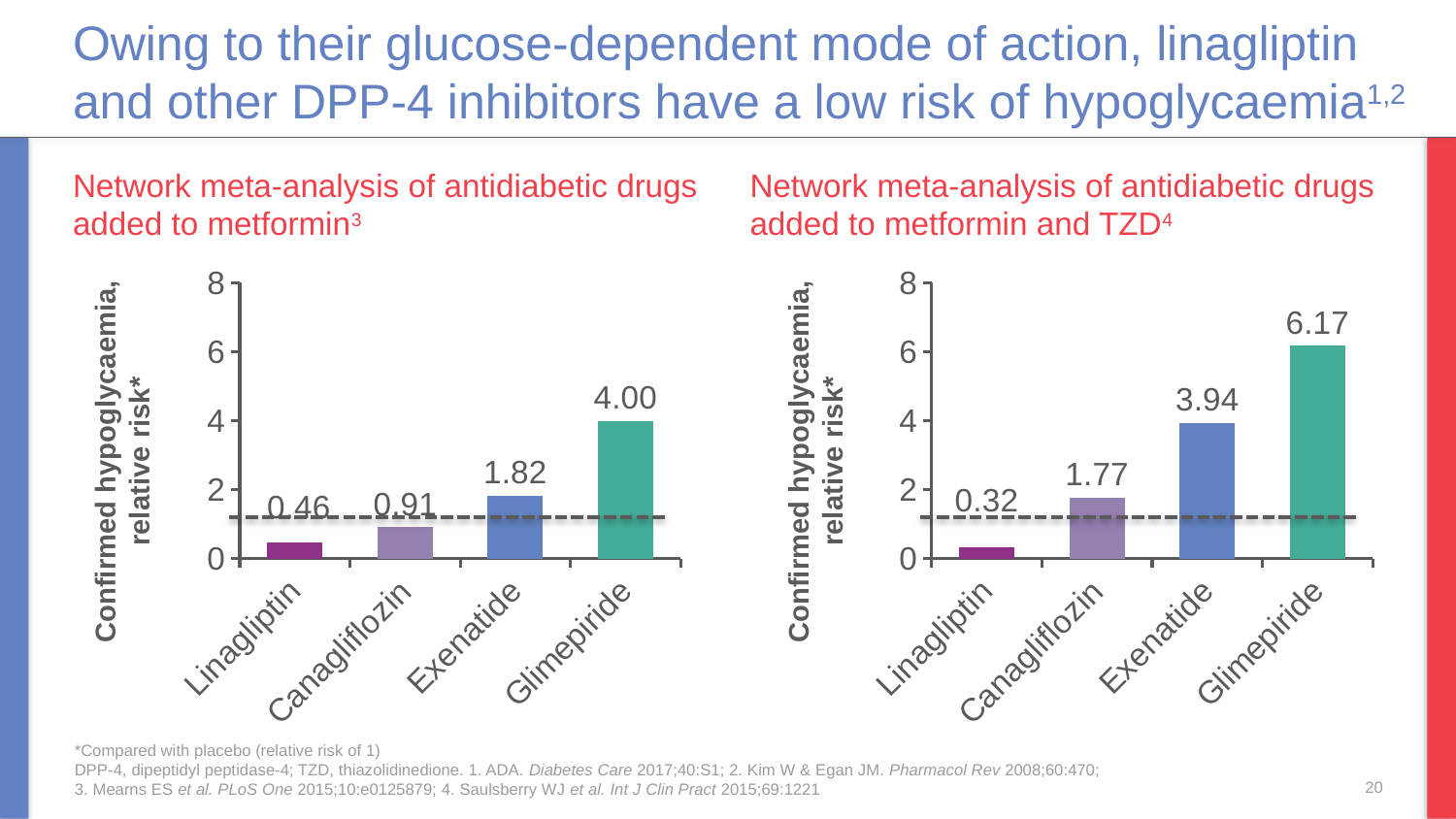
In the right chart (added to metformin and TZD), is the value for Glimepiride greater or less than 6? greater In the left chart (added to metformin), which is larger, the value for Canagliflozin or the value for Exenatide? Exenatide In the right chart (added to metformin and TZD), what is the confirmed hypoglycaemia relative risk for Glimepiride? 6.17 In the left chart (added to metformin), what is the difference between the values for Glimepiride and Linagliptin? 3.54 How many drugs are shown on the x axis of the left chart (added to metformin)? 4 In the left chart (added to metformin), do the values rise or fall from Linagliptin to Glimepiride along the x axis? Rise In the right chart (added to metformin and TZD), which drug has the lowest relative risk? Linagliptin In the left chart (added to metformin), which drug has the highest relative risk? Glimepiride In the left chart (added to metformin), what is the confirmed hypoglycaemia relative risk for Linagliptin? 0.46 What type of chart is used in the right chart (added to metformin and TZD)? Bar chart In the right chart (added to metformin and TZD), what is the value for Exenatide? 3.94 In the right chart (added to metformin and TZD), what is the difference between the values for Glimepiride and Exenatide? 2.23